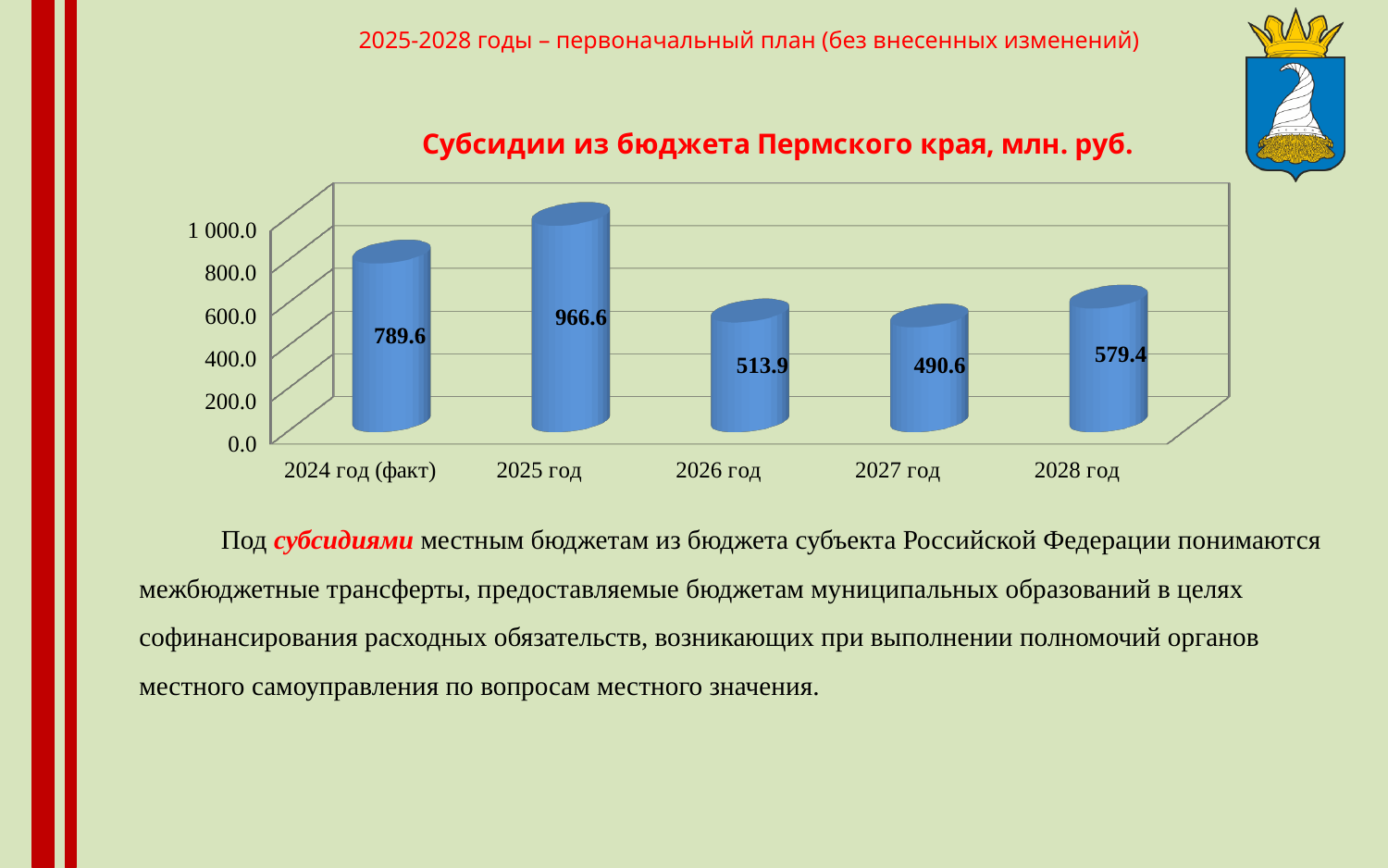
Which year has the highest value? 2025 год What is the title of the chart? Субсидии из бюджета Пермского края, млн. руб. What is the difference between the values for 2028 год and 2027 год? 88.8 What kind of chart is shown on the slide? bar chart Which year has the lowest value? 2027 год Which is larger, the value for 2026 год or the value for 2028 год? 2028 год What is the value for 2027 год? 490.6 What is the value for 2024 год (факт)? 789.6 What is the value for 2025 год? 966.6 How many years are shown on the chart? 5 Is the value for 2026 год greater or less than 600.0? less What is the difference between the values for 2025 год and 2024 год (факт)? 177.0